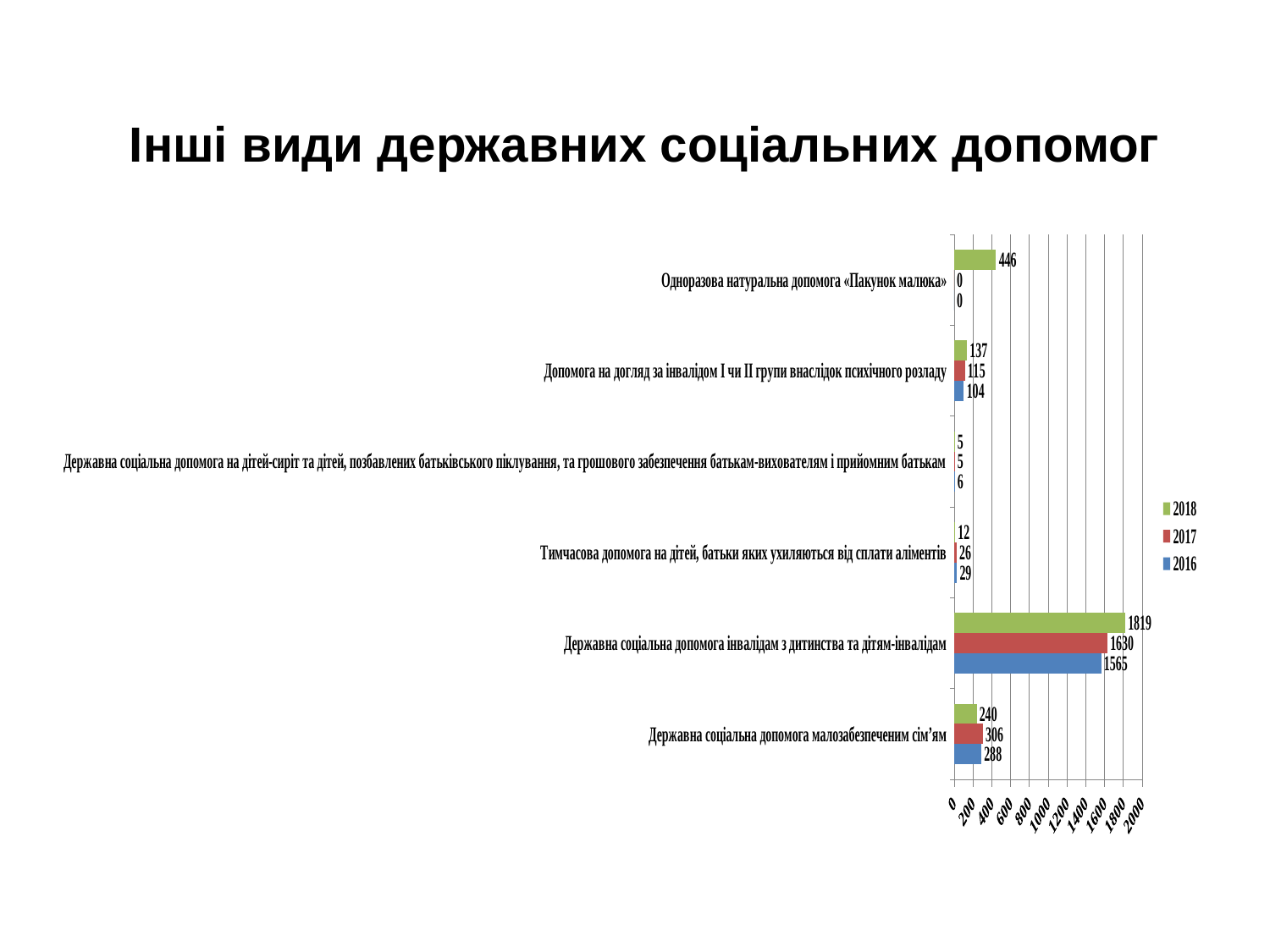
Which category has the lowest 2016 value? Одноразова натуральна допомога «Пакунок малюка» What type of chart is shown on the slide? bar chart How many categories are plotted on the chart? 6 How many series does the legend list? 3 Is the 2018 value for «Державна соціальна допомога інвалідам з дитинства та дітям-інвалідам» greater or less than 1600? greater What is the 2017 value for «Державна соціальна допомога малозабезпеченим сім'ям»? 306 What is the 2016 value for «Державна соціальна допомога інвалідам з дитинства та дітям-інвалідам»? 1565 For «Державна соціальна допомога малозабезпеченим сім'ям», which is larger: the 2017 value or the 2018 value? 2017 Which category has the highest 2018 value? Державна соціальна допомога інвалідам з дитинства та дітям-інвалідам What is the title of the chart? Інші види державних соціальних допомог What is the 2018 value for «Одноразова натуральна допомога «Пакунок малюка»»? 446 What is the difference between the 2018 and 2017 values for «Державна соціальна допомога інвалідам з дитинства та дітям-інвалідам»? 189